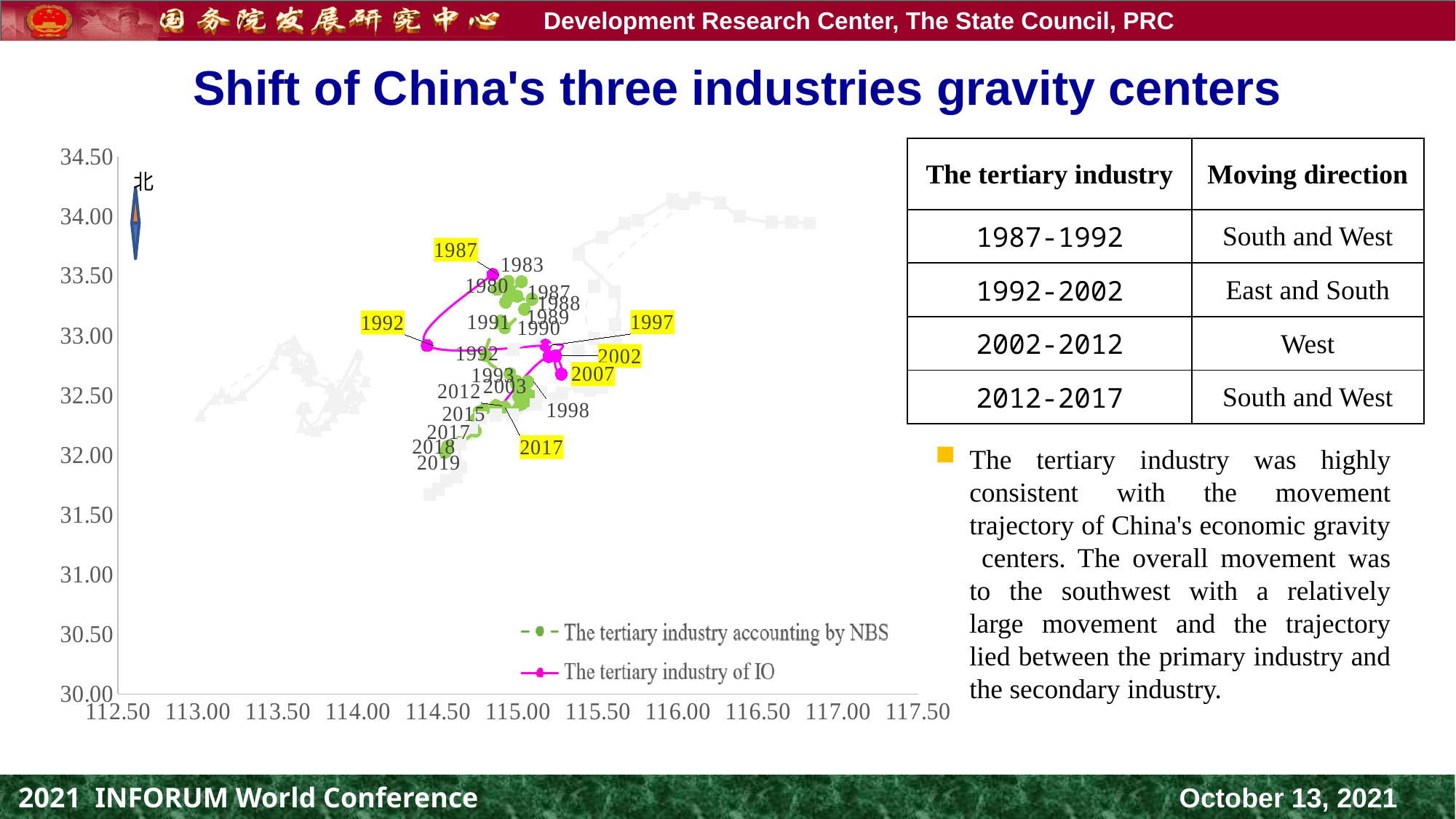
Is the longitude (x value) of the 2007 point of the tertiary industry of IO series greater or less than 115.00? greater Is the longitude (x value) of the 1992 point of the tertiary industry of IO series greater or less than 115.00? less Which point of the tertiary industry of IO series lies further east (higher longitude): 1992 or 1997? 1997 Is the latitude (y value) of the 1987 point of the tertiary industry of IO series greater or less than 33.00? greater Which series in the chart is drawn in magenta? The tertiary industry of IO Which point of the tertiary industry of IO series lies further north (higher latitude): 1987 or 2007? 1987 What kind of chart is shown on the left of the slide? scatter (line) chart Which series in the chart is drawn with a green dashed line? The tertiary industry accounting by NBS How many year labels are highlighted in yellow on the chart? 6 How many series does the chart legend list? 2